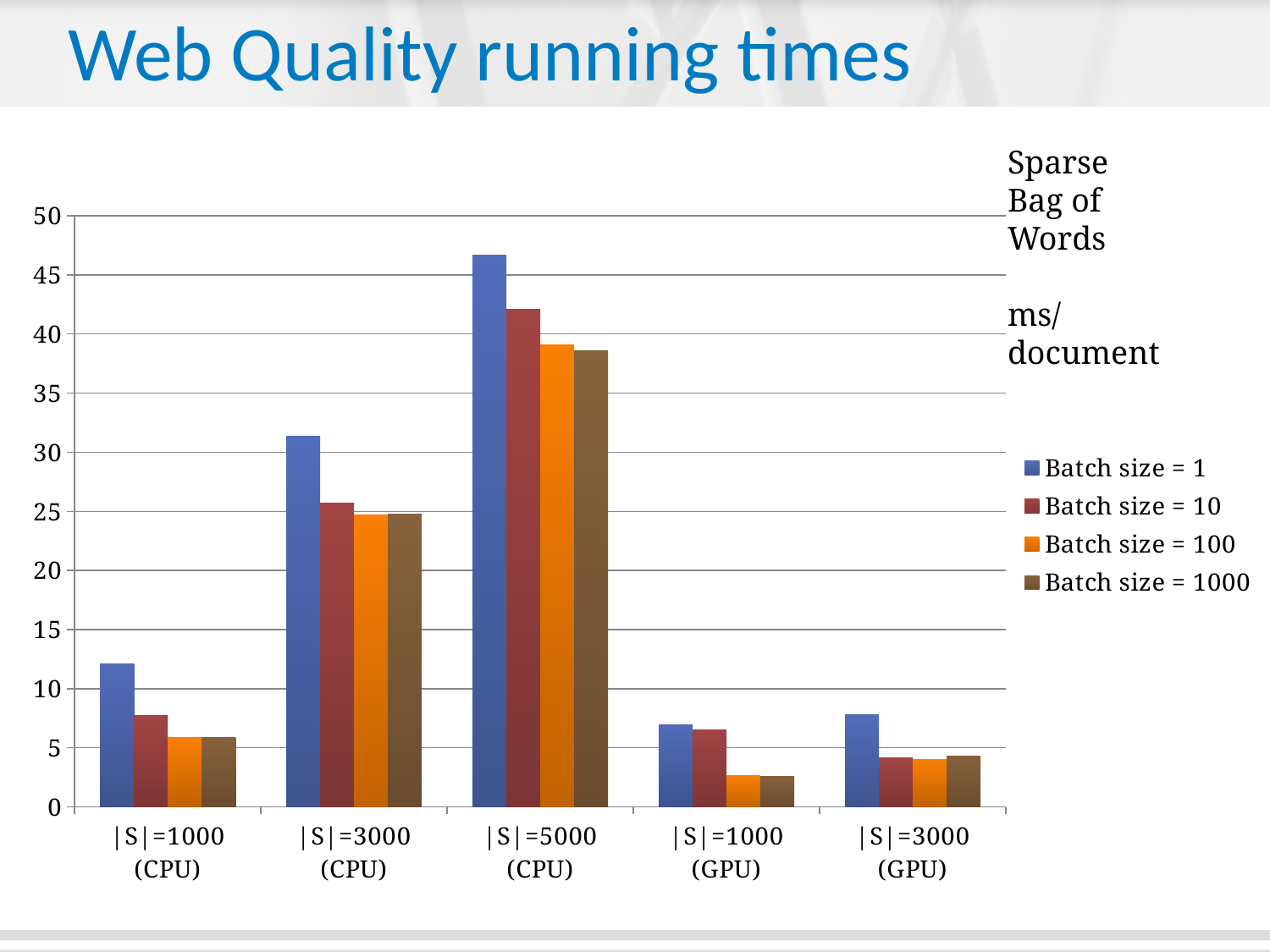
Which category has the highest bar for Batch size = 1? |S|=5000 (CPU) Is the value for Batch size = 10 at |S|=5000 (CPU) greater or less than 40? greater Across the three CPU categories, do the Batch size = 1 values rise or fall as |S| increases? rise How many series does the legend list? 4 Is the value for Batch size = 1 at |S|=5000 (CPU) greater or less than 45? greater For Batch size = 10, which is larger: |S|=3000 (CPU) or |S|=3000 (GPU)? |S|=3000 (CPU) Is the value for Batch size = 1 at |S|=3000 (CPU) greater or less than 30? greater What kind of chart is shown on the slide? bar chart For |S|=1000 (CPU), which is larger: Batch size = 1 or Batch size = 10? Batch size = 1 What unit is given for the values in the chart? ms/document How many categories are shown along the x axis? 5